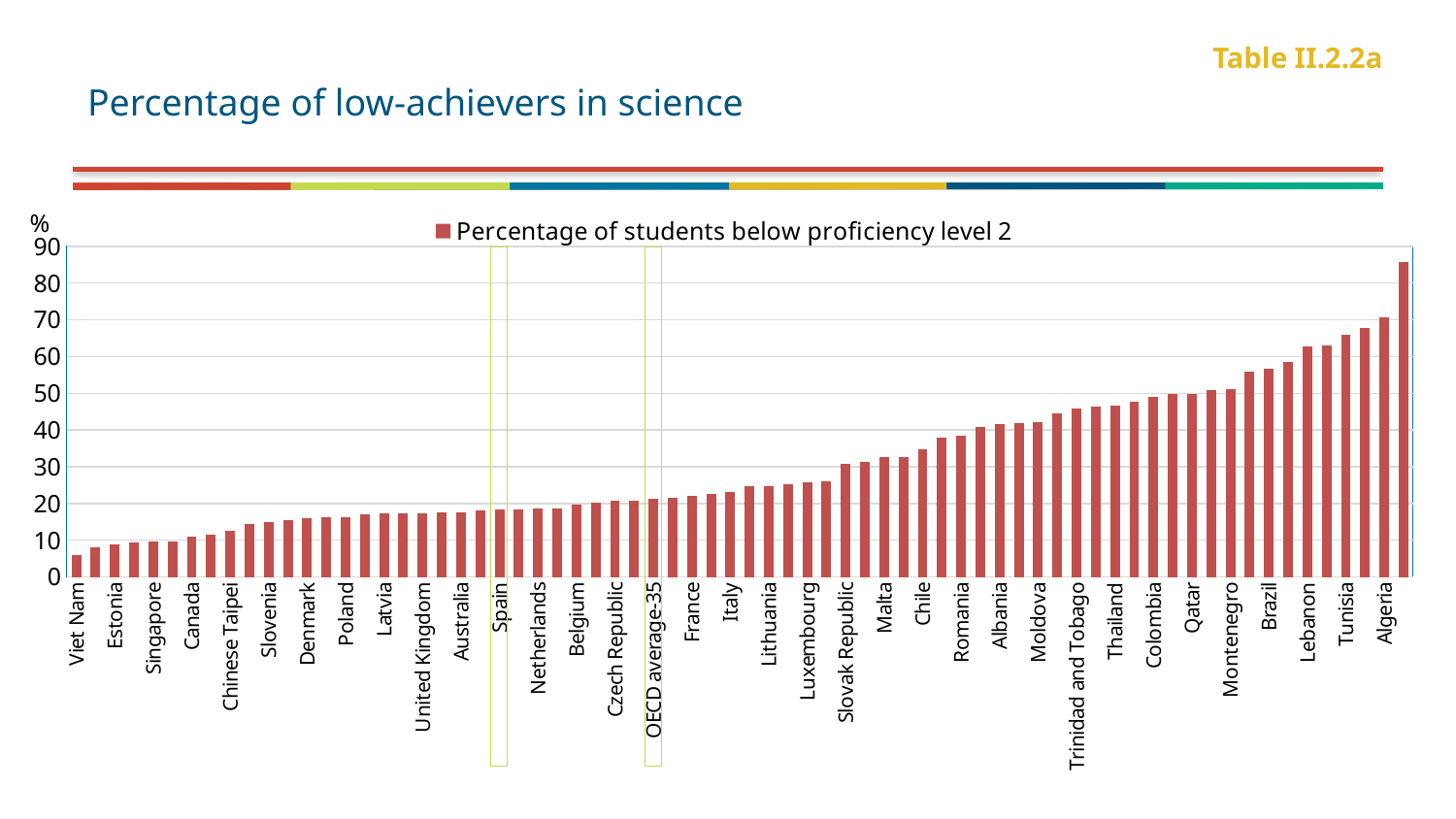
Is the value for Algeria greater or less than 80? less Which has a higher percentage of low-achievers in science, Brazil or Spain? Brazil What is the legend entry for the series shown in the chart? Percentage of students below proficiency level 2 Is the value for Viet Nam greater or less than 10? less Is the value for Chile greater or less than 30? greater How many series does the legend list? 1 What kind of chart is shown on the slide? Bar chart Do the values generally rise or fall moving from left to right along the x axis? Rise Which country has the lowest percentage of low-achievers in science? Viet Nam